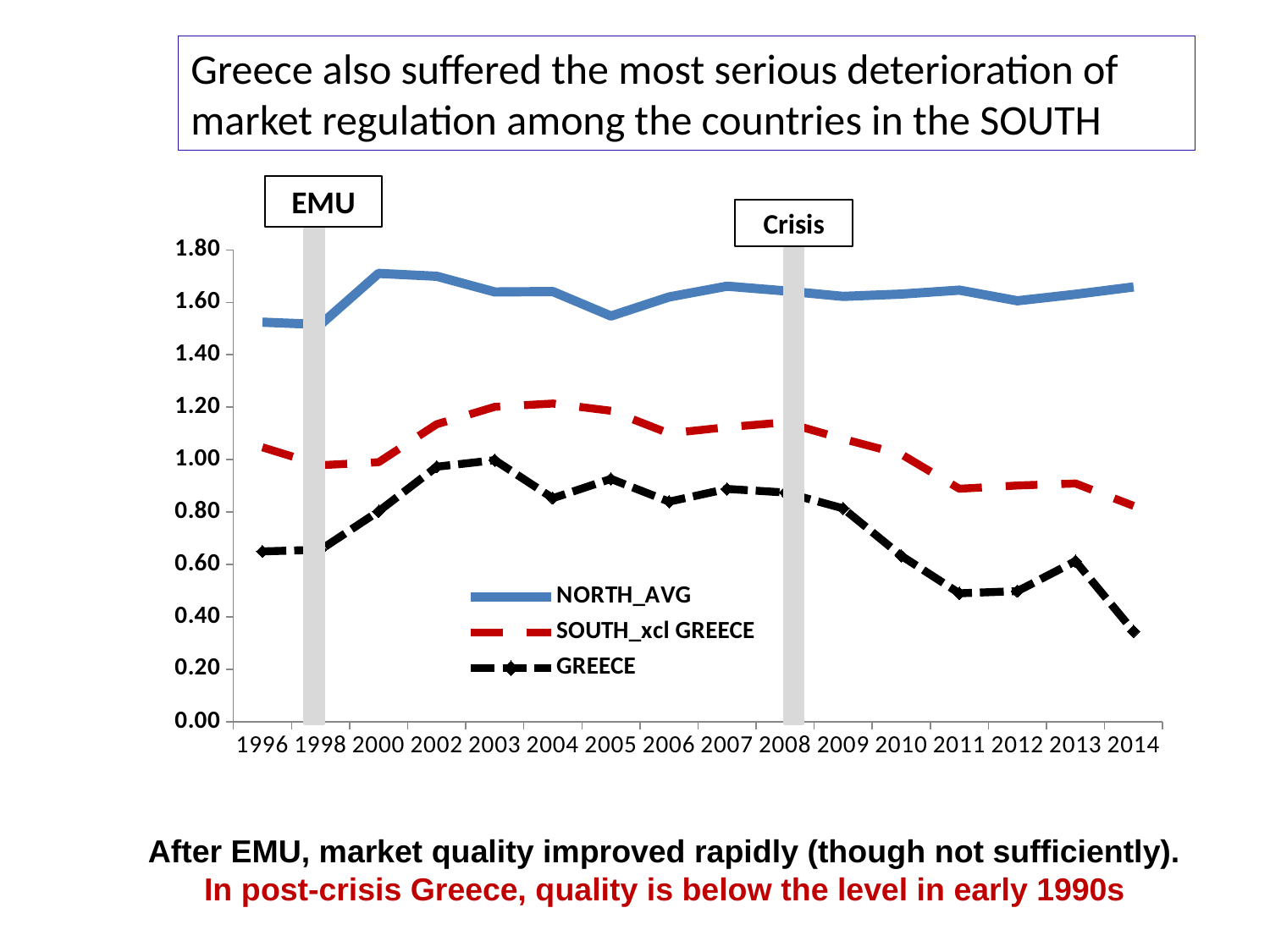
Which series has the highest values across all years shown? NORTH_AVG Is the value for GREECE in 2014 greater or less than 0.40? less How many years are labelled along the x axis of the chart? 16 What kind of chart is shown on the slide? line chart Is the value for SOUTH_xcl GREECE in 2004 greater or less than 1.00? greater Is the value for SOUTH_xcl GREECE in 2014 greater or less than 1.00? less Does the GREECE series rise or fall overall from 2009 to 2014? fall In 2014, which series has the higher value, NORTH_AVG or GREECE? NORTH_AVG How many series does the chart's legend list? 3 In which year does the GREECE series reach its lowest value? 2014